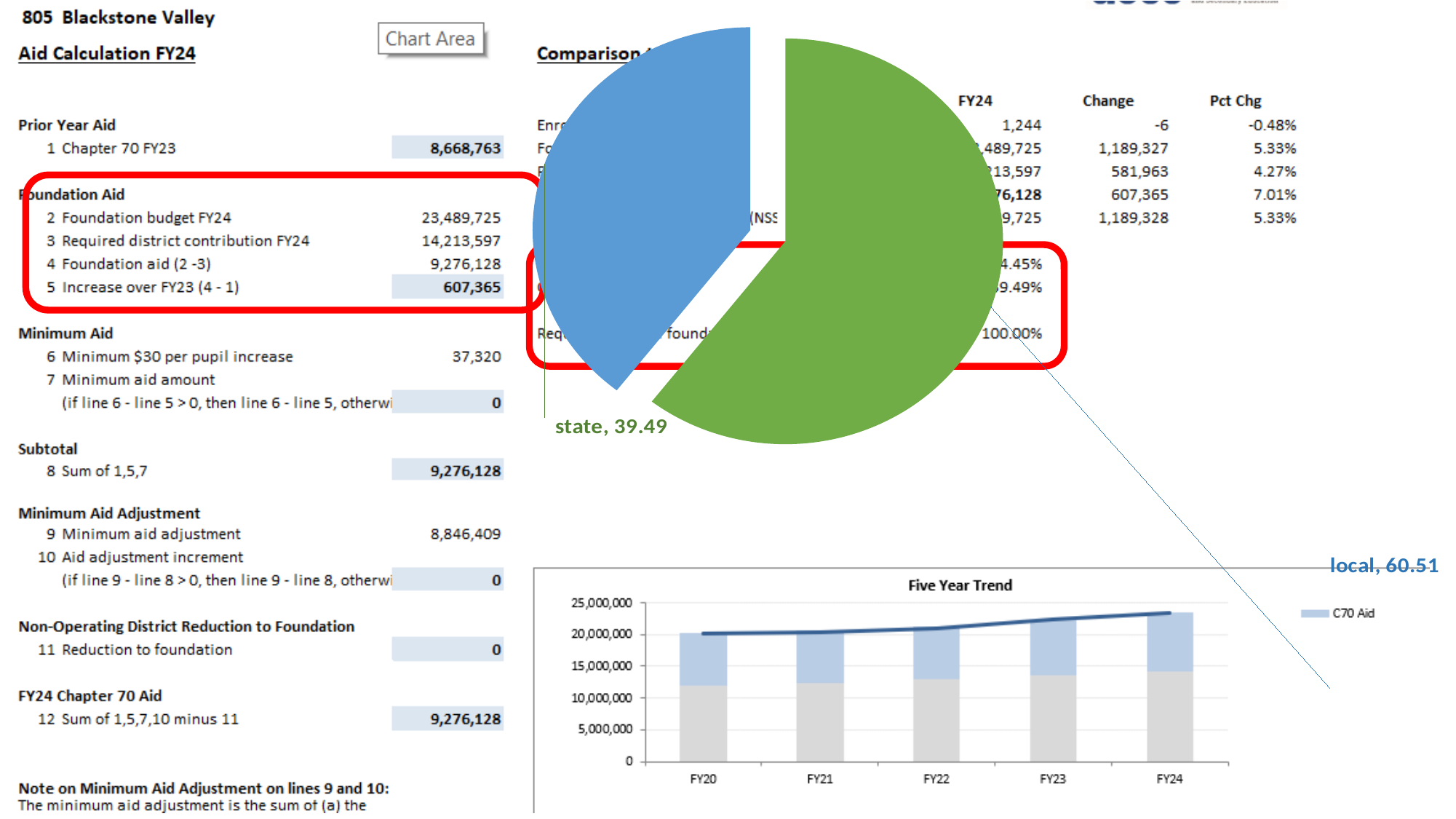
How many slices does the pie chart have? 2 In the Five Year Trend chart, do the total bar heights rise or fall from FY20 to FY24? rise In the Five Year Trend chart, is the total bar height for FY21 greater or less than 25,000,000? less In the pie chart, what is the difference between the local value and the state value? 21.02 What kind of chart is the Five Year Trend chart? bar chart In the pie chart, which slice is larger, state or local? local In the pie chart, which slice is the smallest? state In the Five Year Trend chart, is the total bar height for FY24 greater or less than 20,000,000? greater How many fiscal years are shown on the x axis of the Five Year Trend chart? 5 In the pie chart, what is the value shown for the local slice? 60.51 In the pie chart, what is the value shown for the state slice? 39.49 What is the title of the chart at the bottom right of the slide? Five Year Trend